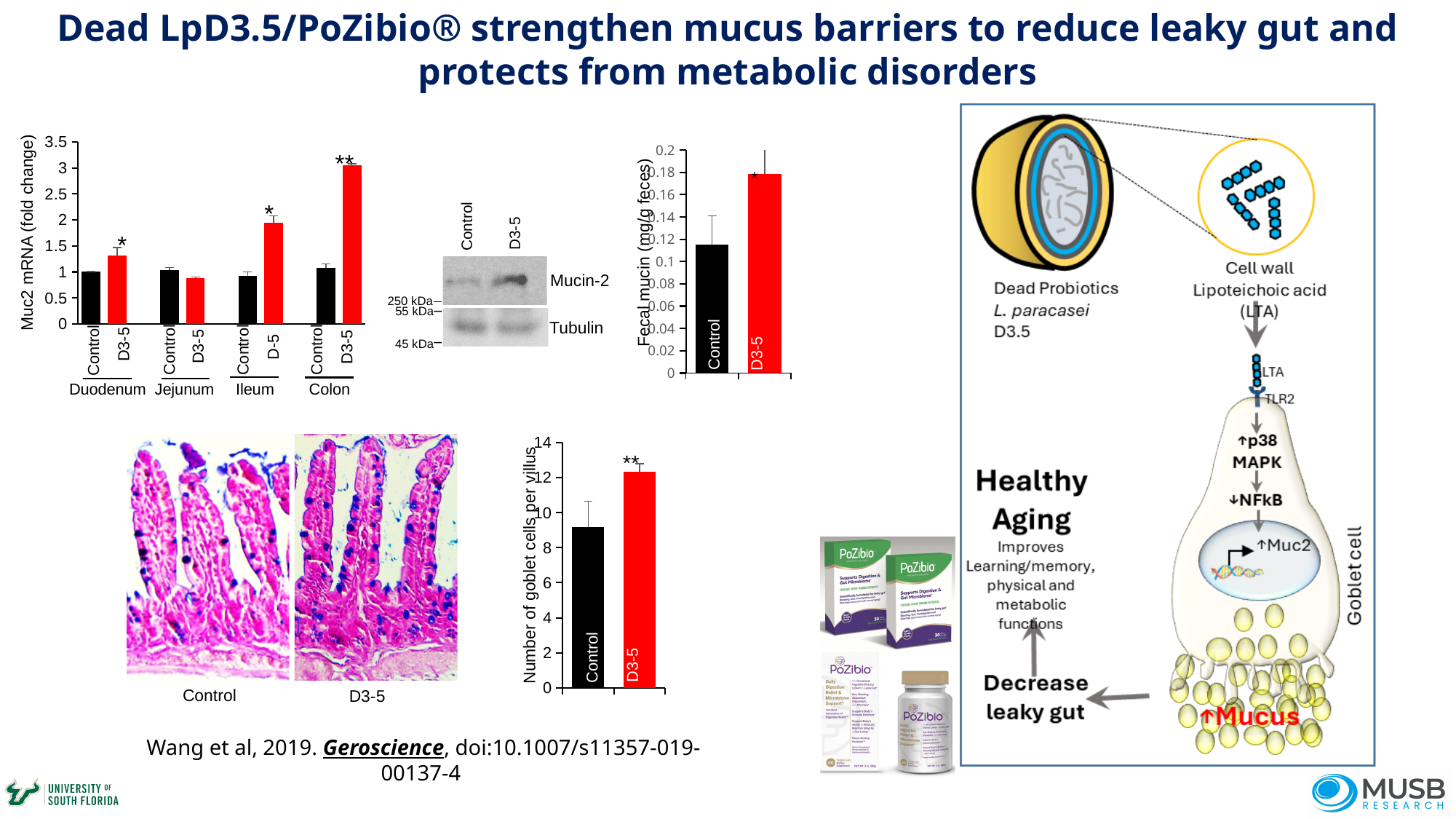
What type of chart is the Number of goblet cells per villus chart? bar chart In the Fecal mucin (mg/g feces) chart, is the value for D3-5 greater or less than 0.16? greater In the Number of goblet cells per villus chart, is the value for Control greater or less than 10? less In the Muc2 mRNA (fold change) chart, is the D-5 value for Ileum greater or less than 1.5? greater In the Muc2 mRNA (fold change) chart, which is larger for Ileum: Control or D-5? D-5 In the Muc2 mRNA (fold change) chart, which bar is the highest? D3-5 in Colon In the Fecal mucin (mg/g feces) chart, which group has the higher value: Control or D3-5? D3-5 In the Muc2 mRNA (fold change) chart, how many intestinal segments are shown along the x axis? 4